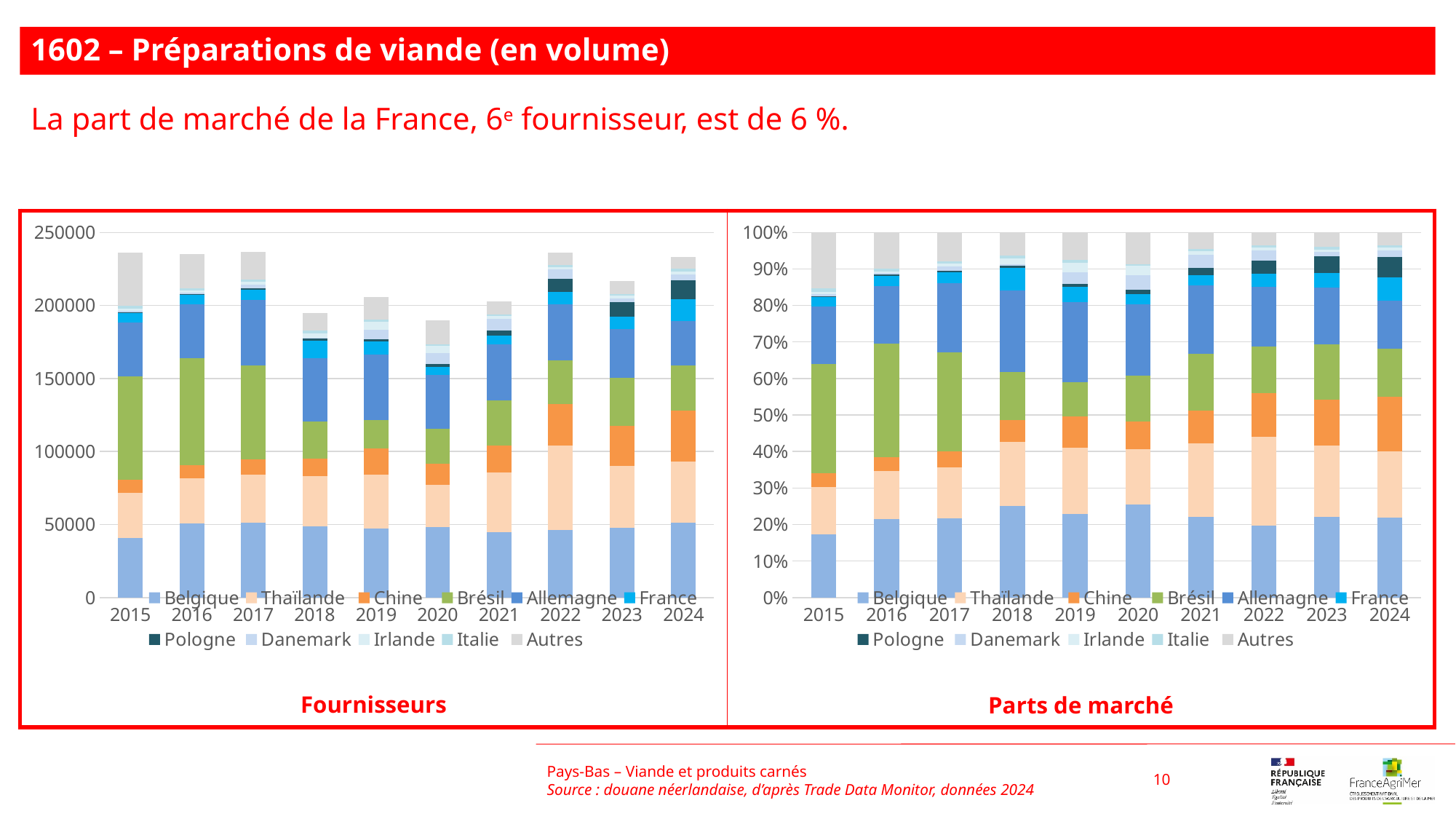
How many series does the legend of the 'Fournisseurs' chart list? 11 In the 'Parts de marché' chart, does the Brésil share rise or fall from 2015 to 2024? Fall In the 'Fournisseurs' chart, is the Belgique value for 2015 greater or less than 50000? less In the 'Fournisseurs' chart, is the total for 2022 greater or less than 200000? greater What is the title of the right-hand chart? Parts de marché What kind of chart is the 'Fournisseurs' chart? Stacked bar chart How many years are shown on the x axis of the 'Parts de marché' chart? 10 In the 'Fournisseurs' chart, which is larger in 2015: the Brésil segment or the Allemagne segment? Brésil In the 'Parts de marché' chart, is the Belgique share for 2015 greater or less than 20%? less How many charts are on the slide? 2